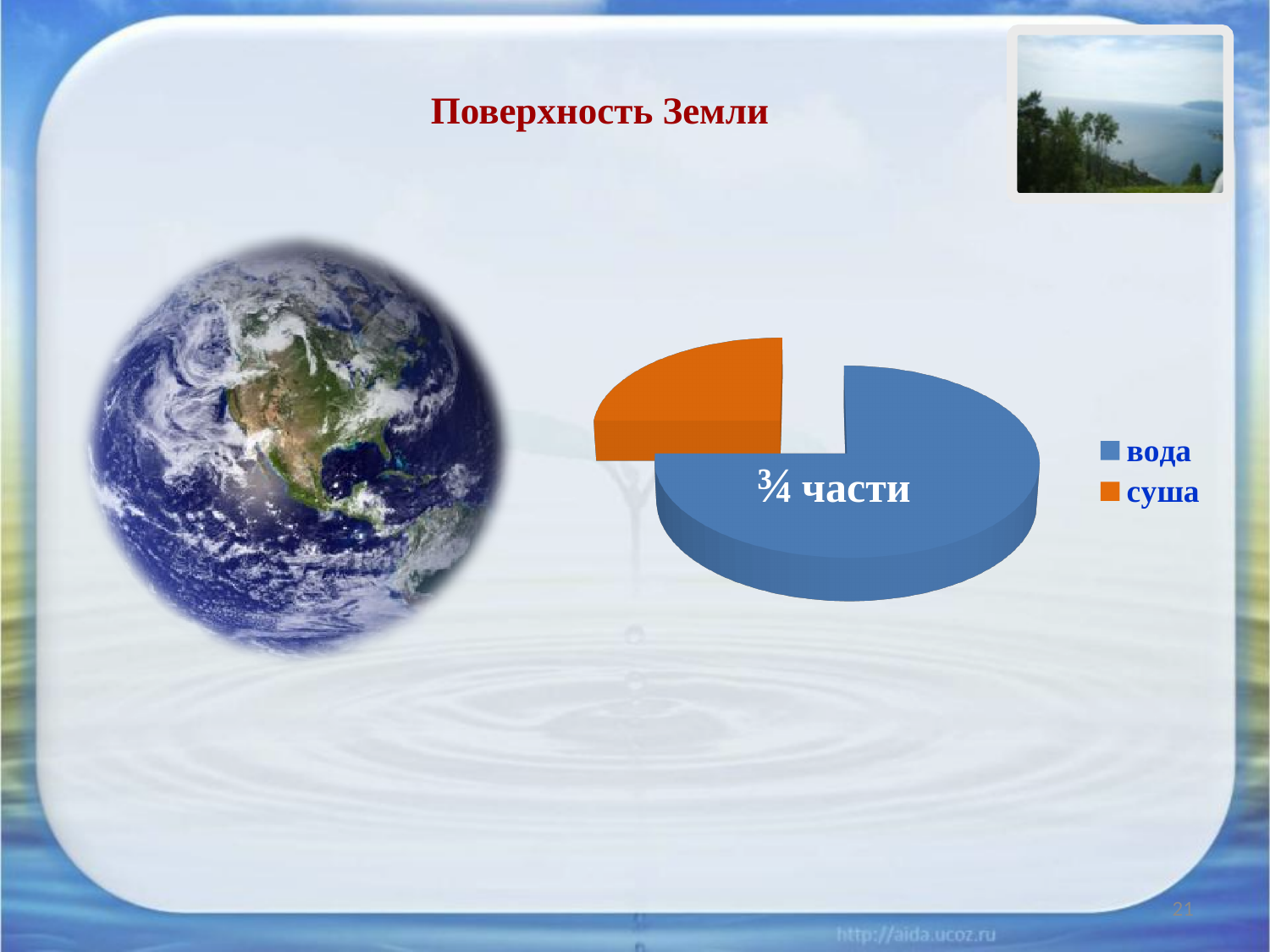
What kind of chart is shown on the slide? pie chart What label is printed on the вода slice of the pie chart? ¾ части What is the title of the slide containing the pie chart? Поверхность Земли Which is larger in the pie chart, вода or суша? вода How many entries does the legend of the pie chart list? 2 What share of the pie does the вода slice represent, as printed on the chart? ¾ части Which legend entry is shown in blue? вода Which slice of the pie chart is the smallest? суша How many slices does the pie chart have? 2 What colour is the суша slice in the pie chart? orange Which slice of the pie chart is the largest? вода